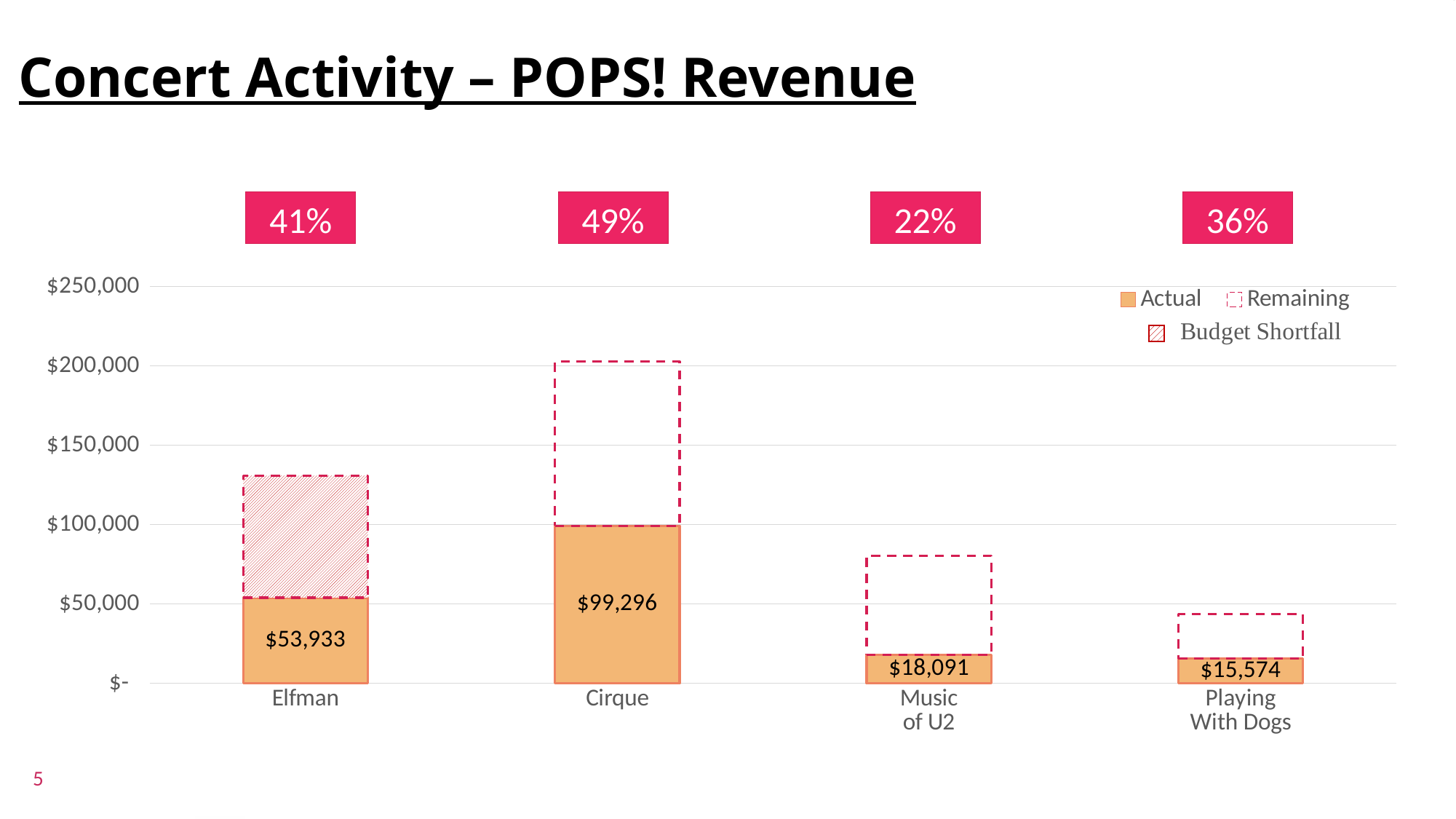
What is the Actual revenue for Playing With Dogs? $15,574 Is the total height of the Cirque bar (Actual plus Remaining) greater or less than $150,000? greater What is the difference between the Actual revenue for Cirque and for Elfman? $45,363 Which has the larger Actual revenue, Music of U2 or Playing With Dogs? Music of U2 What is the Actual revenue for Cirque? $99,296 Which concert has the highest Actual revenue? Cirque What is the Actual revenue for Elfman? $53,933 How many concerts are shown on the x axis? 4 What percentage is shown above the Music of U2 bar? 22% Which concert has the lowest Actual revenue? Playing With Dogs How many series does the legend list? 3 What is the Actual revenue for Music of U2? $18,091